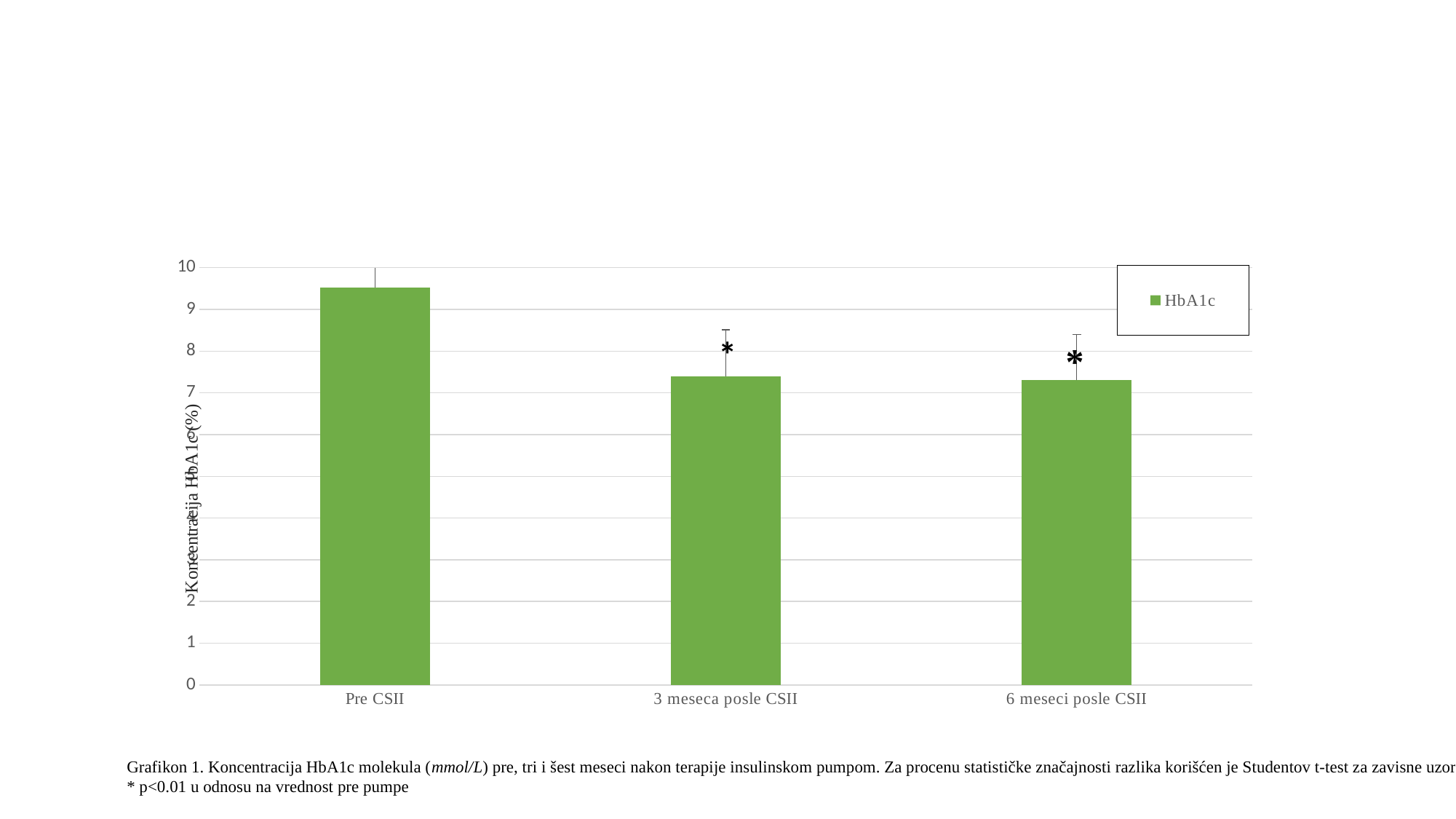
Which category has the highest HbA1c value? Pre CSII What series name is shown in the chart legend? HbA1c Is the HbA1c value for 3 meseca posle CSII greater or less than 8? less Which is larger, the HbA1c value for Pre CSII or for 3 meseca posle CSII? Pre CSII Is the HbA1c value for 6 meseci posle CSII greater or less than 8? less How many categories are shown on the x axis of the chart? 3 What is the label of the vertical axis of the chart? Koncentracija HbA1c (%) What kind of chart is shown on the slide? bar chart Is the HbA1c value for Pre CSII greater or less than 9? greater Do the HbA1c values rise or fall from Pre CSII to 6 meseci posle CSII? fall How many series does the chart legend list? 1